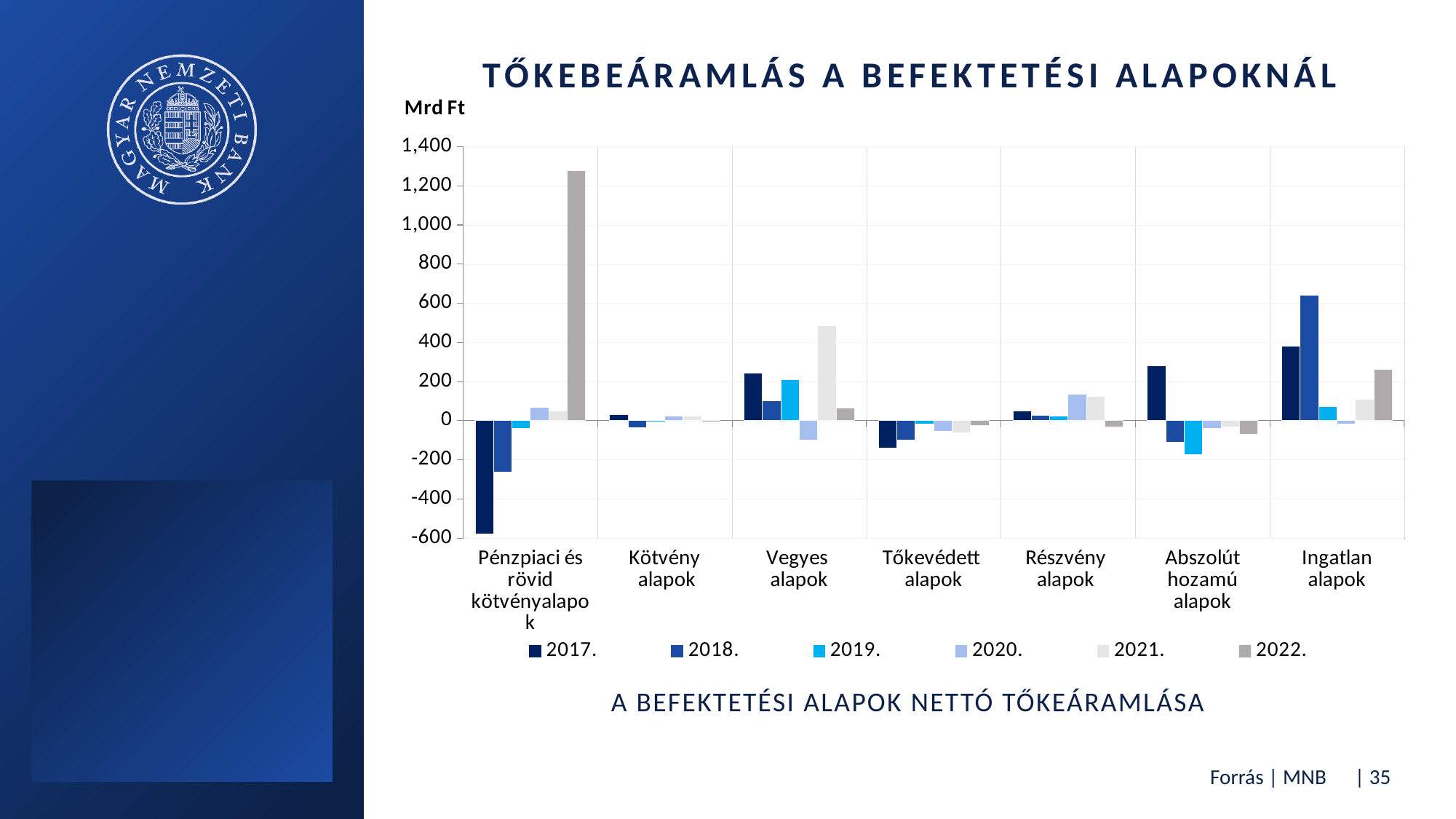
Is the 2019 value for Abszolút hozamú alapok greater or less than -100? less Which year has the highest bar for Pénzpiaci és rövid kötvényalapok? 2022. What kind of chart is shown on the slide? bar chart What unit is shown on the y axis of the chart? Mrd Ft How many series does the legend list? 6 Which year has the highest bar for Ingatlan alapok? 2018. Which year has the lowest bar for Pénzpiaci és rövid kötvényalapok? 2017. Is the 2022 value for Pénzpiaci és rövid kötvényalapok greater or less than 1,000? greater Which is larger, the 2017 value for Ingatlan alapok or the 2017 value for Abszolút hozamú alapok? Ingatlan alapok Which year has the highest bar for Vegyes alapok? 2021. Is the 2017 value for Pénzpiaci és rövid kötvényalapok greater or less than -400? less How many fund categories are shown on the x axis? 7